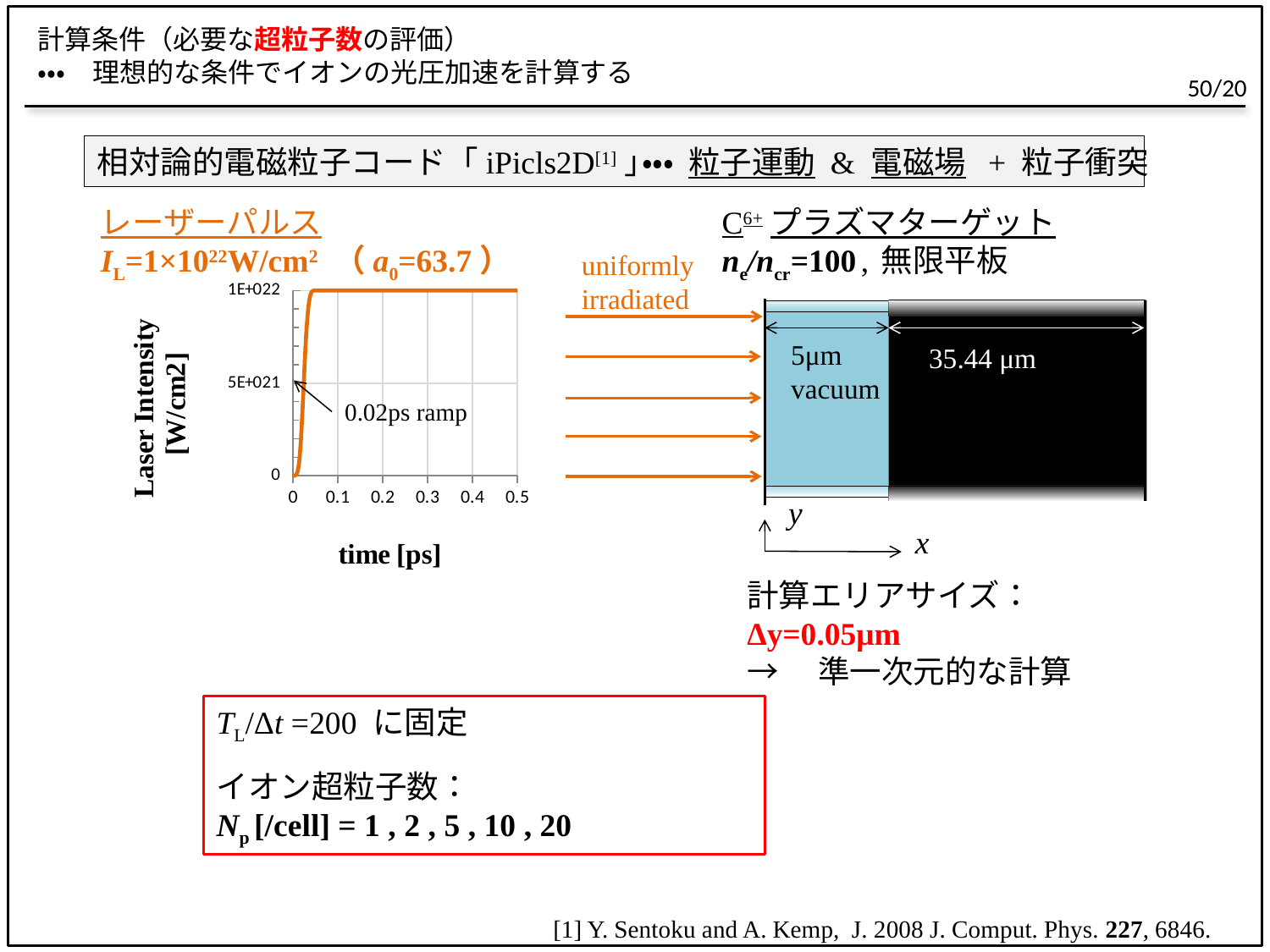
What is the largest time value shown on the x axis of the laser intensity chart? 0.5 How many tick labels are shown on the x axis of the laser intensity chart? 6 How does the laser intensity change along the time axis? rises sharply then stays flat Is the laser intensity at time 0 ps greater or less than 5E+021? less What is the label of the x axis of the laser intensity chart? time [ps] What is the highest value shown on the y axis of the laser intensity chart? 1E+022 Is the laser intensity at time 0.3 ps greater or less than 5E+021? greater What ramp duration is annotated on the laser intensity chart? 0.02ps ramp What kind of chart is shown on the left of the slide? line chart What is the label of the y axis of the laser intensity chart? Laser Intensity [W/cm2] At what level does the laser intensity plateau after the ramp? 1E+022